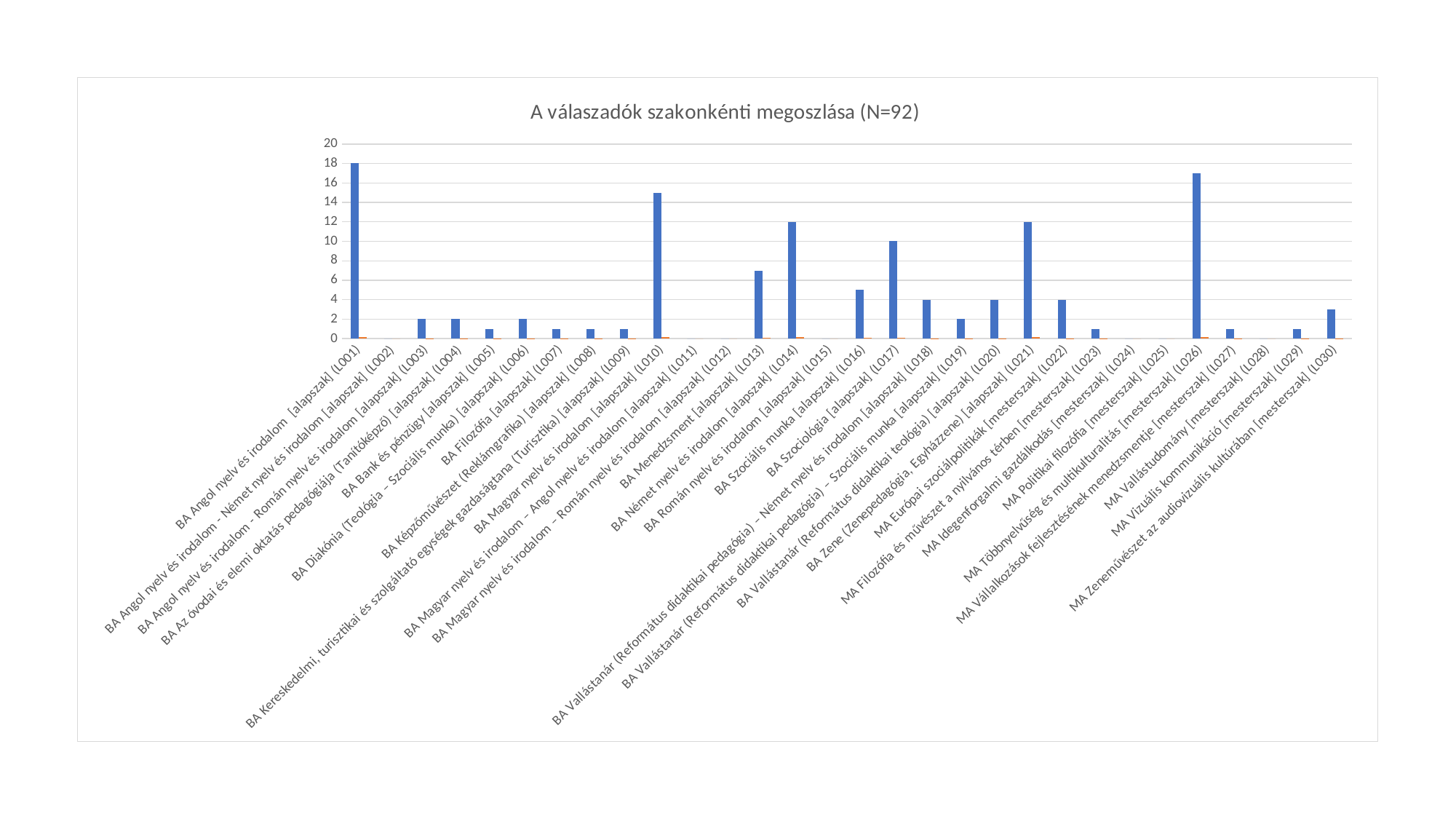
What is the title of the chart? A válaszadók szakonkénti megoszlása (N=92) What kind of chart is shown on the slide? bar chart Which category has the highest value? BA Angol nyelv és irodalom [alapszak] (L001) How many categories (szakok) are shown on the x axis? 30 Is the value for BA Magyar nyelv és irodalom [alapszak] (L010) greater or less than 14? greater What is the value for BA Angol nyelv és irodalom [alapszak] (L001)? 18